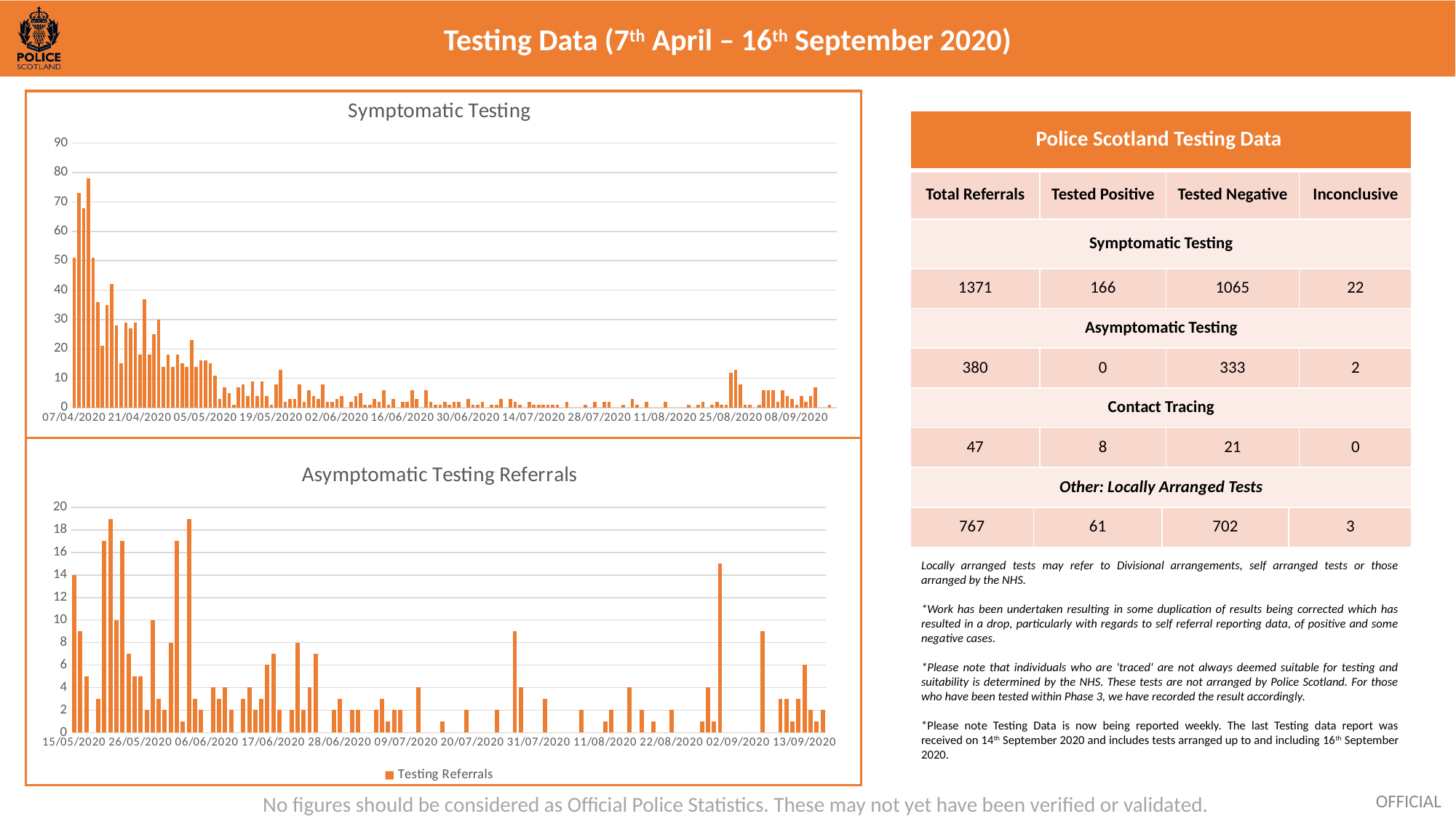
What is the legend entry shown on the Asymptomatic Testing Referrals chart? Testing Referrals What type of chart is the Asymptomatic Testing Referrals chart? bar chart In the Asymptomatic Testing Referrals chart, is the tallest bar greater or less than 16? greater In the Symptomatic Testing chart, do the values generally rise or fall from April to September 2020? fall In the Symptomatic Testing chart, which is larger: the first bar at 07/04/2020 or the bars around 28/07/2020? the first bar at 07/04/2020 What is the highest value shown on the y axis of the Symptomatic Testing chart? 90 In the Symptomatic Testing chart, is the tallest bar greater or less than 70? greater What type of chart is the Symptomatic Testing chart? bar chart In the Symptomatic Testing chart, are the bars around 08/09/2020 greater or less than 20? less How many series does the legend of the Asymptomatic Testing Referrals chart list? 1 What is the first date label on the x axis of the Asymptomatic Testing Referrals chart? 15/05/2020